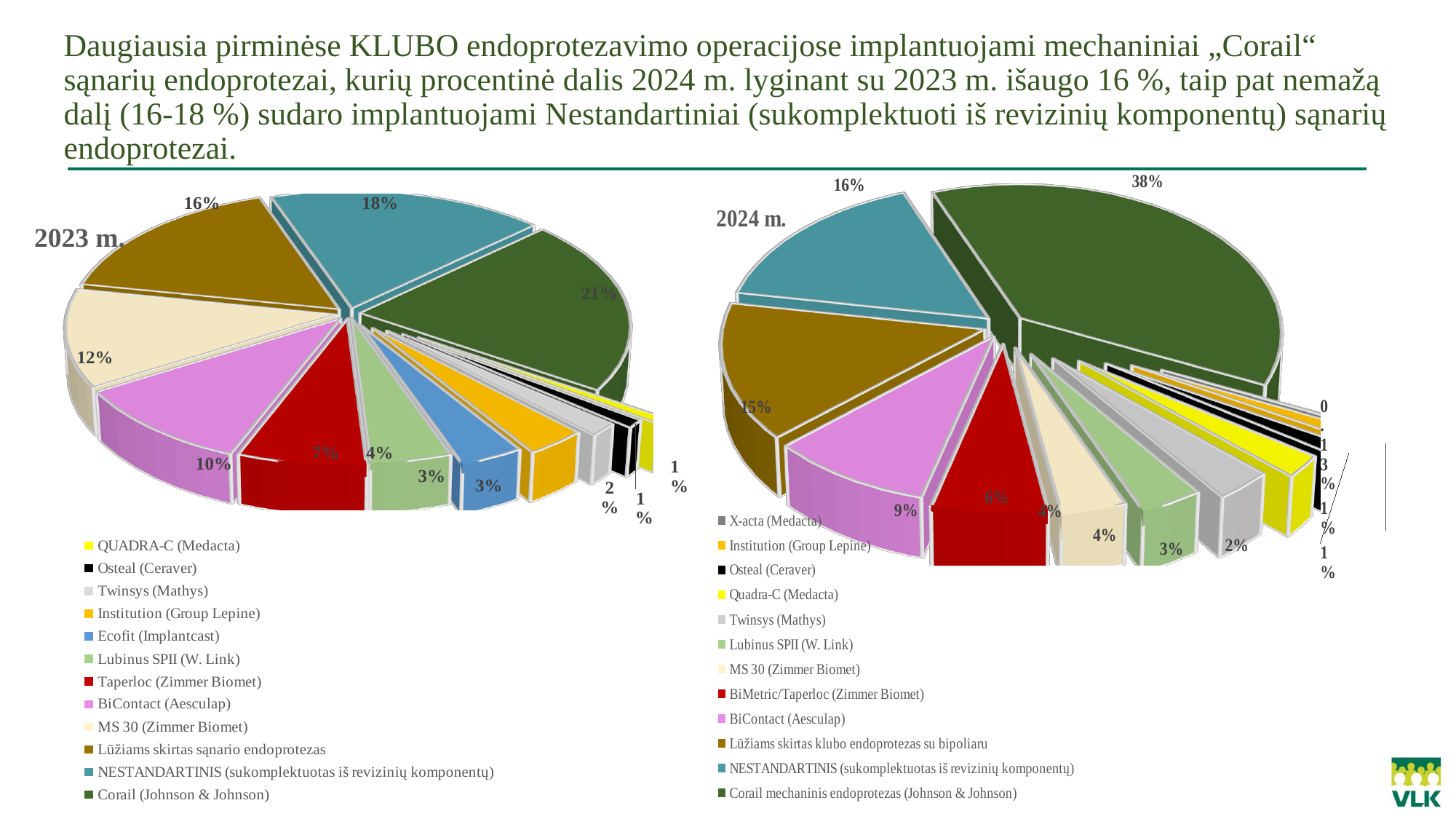
In the 2024 m. pie chart, which category has the largest slice? Corail mechaninis endoprotezas (Johnson & Johnson) What type of chart is used for the 2023 m. and 2024 m. data on this slide? Pie chart In the 2023 m. pie chart, what share does NESTANDARTINIS (sukomplektuotas iš revizinių komponentų) have? 18% In the 2024 m. pie chart, what share does BiContact (Aesculap) have? 9% By how many percentage points is the Corail share in the 2024 m. chart larger than in the 2023 m. chart? 17 In the 2024 m. pie chart, what share does NESTANDARTINIS (sukomplektuotas iš revizinių komponentų) have? 16% In the 2023 m. pie chart, which is larger: BiContact (Aesculap) or Taperloc (Zimmer Biomet)? BiContact (Aesculap) In the 2023 m. pie chart, which category has the largest slice? Corail (Johnson & Johnson) How many categories does the legend of the 2023 m. pie chart list? 12